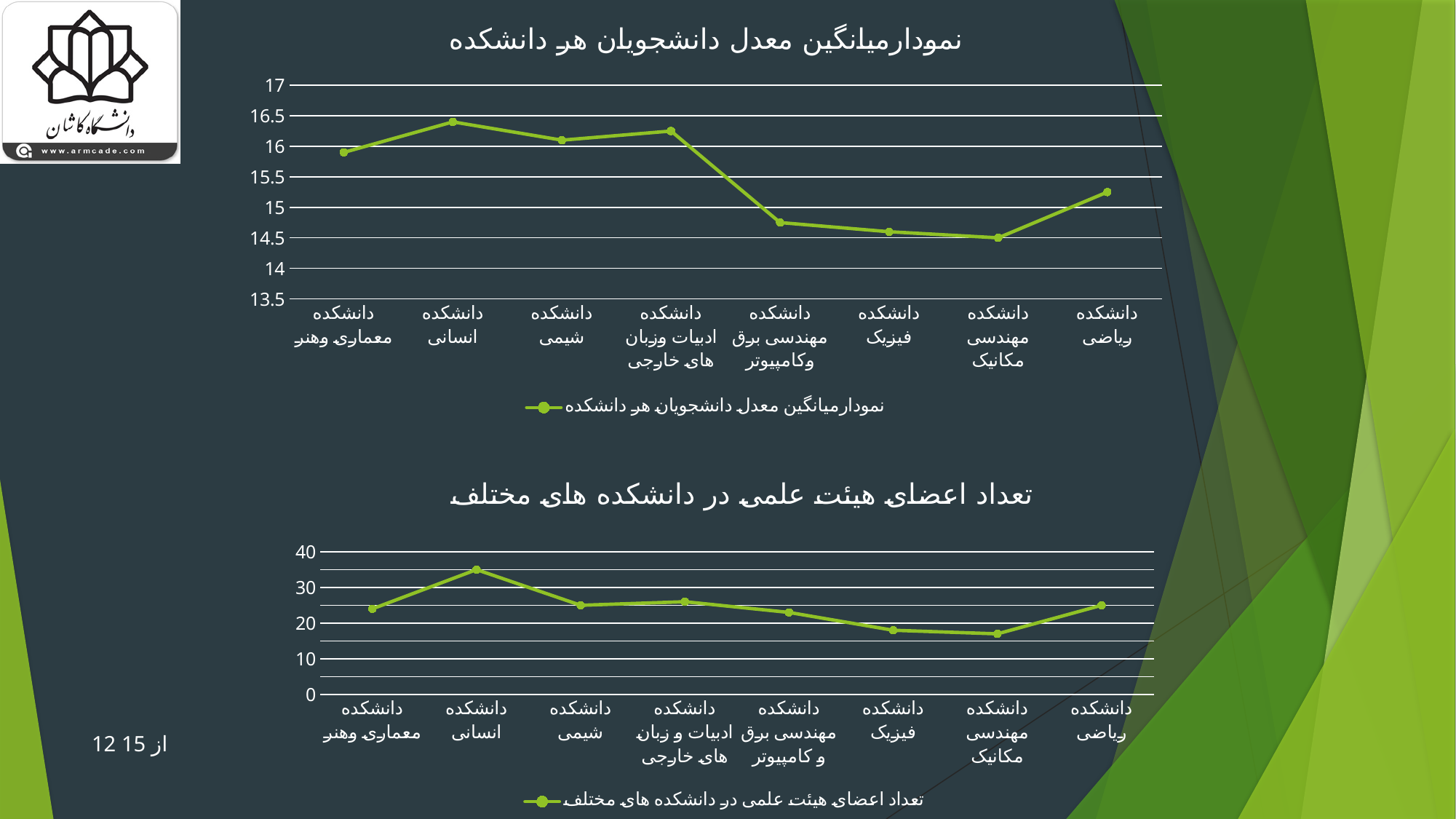
In the bottom chart (number of faculty members), how many series does the legend list? 1 In the bottom chart (number of faculty members), which faculty has the highest value? دانشکده انسانی In the top chart (average GPA per faculty), is the value for دانشکده مهندسی مکانیک greater or less than 15? less What kind of chart is the top chart titled «نمودارمیانگین معدل دانشجویان هر دانشکده»? line chart In the top chart (average GPA per faculty), which has the larger value: دانشکده انسانی or دانشکده فیزیک? دانشکده انسانی In the top chart (average GPA per faculty), is the value for دانشکده انسانی greater or less than 16? greater What kind of chart is the bottom chart titled «تعداد اعضای هیئت علمی در دانشکده های مختلف»? line chart In the bottom chart (number of faculty members), do the values rise or fall from دانشکده انسانی to دانشکده فیزیک? fall In the bottom chart (number of faculty members), is the value for دانشکده فیزیک greater or less than 20? less In the top chart (average GPA per faculty), which faculty has the highest value? دانشکده انسانی In the top chart (average GPA per faculty), how many faculties are plotted along the x axis? 8